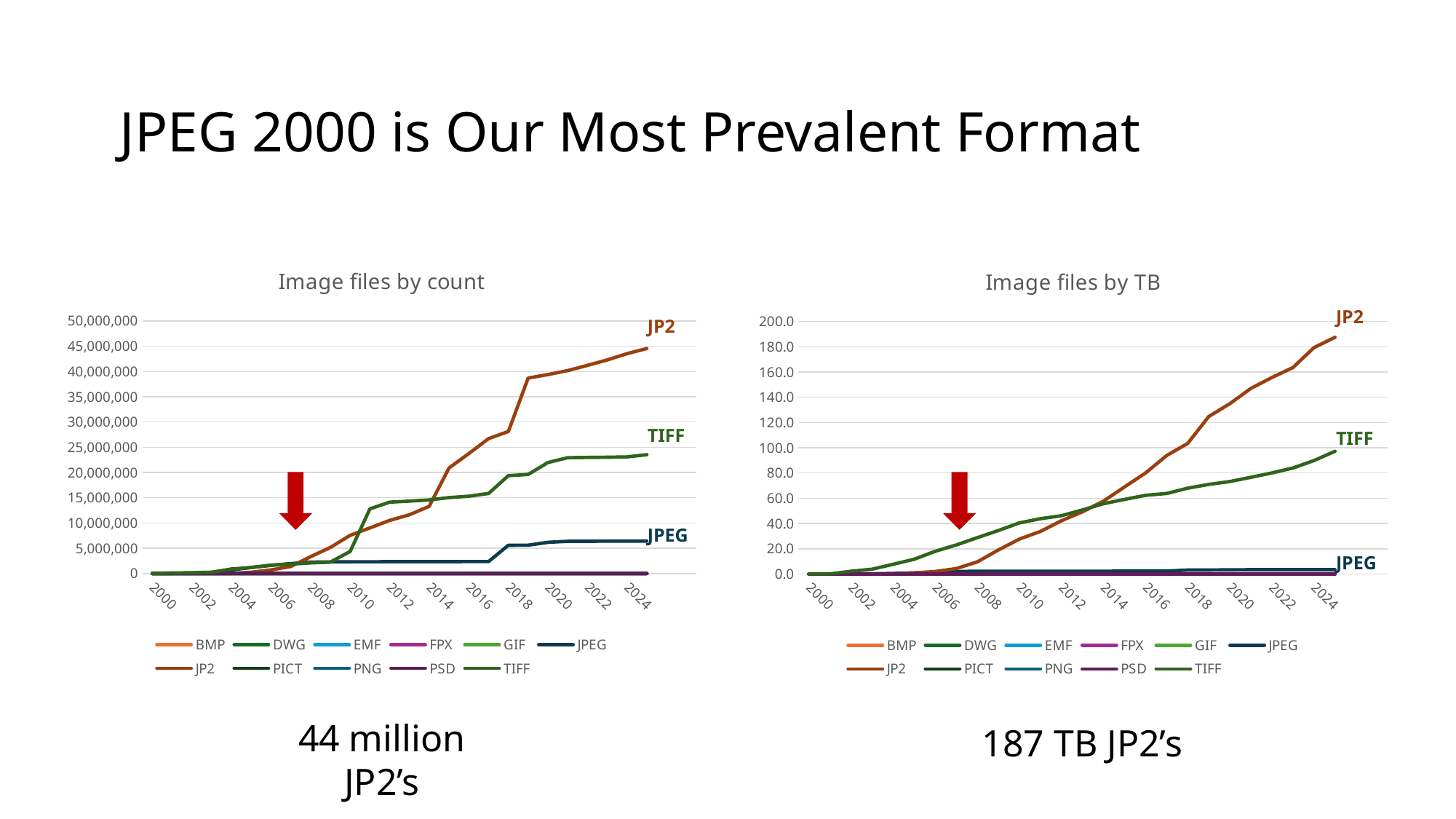
In the "Image files by count" chart, is the TIFF value in 2024 greater or less than 25,000,000? less In the "Image files by TB" chart, does the JP2 line rise or fall from 2008 to 2024? rise In the "Image files by count" chart, is the JP2 value in 2024 greater or less than 40,000,000? greater What is the title of the chart on the left of the slide? Image files by count In the "Image files by TB" chart, which series has the highest value in 2024? JP2 In the "Image files by count" chart, which series has the highest value in 2024? JP2 In the "Image files by TB" chart, is the JPEG value in 2024 greater or less than 20.0? less In the "Image files by count" chart, which is larger in 2024, JP2 or TIFF? JP2 What kind of chart is the "Image files by count" chart? line chart How many series does the legend of the "Image files by TB" chart list? 11